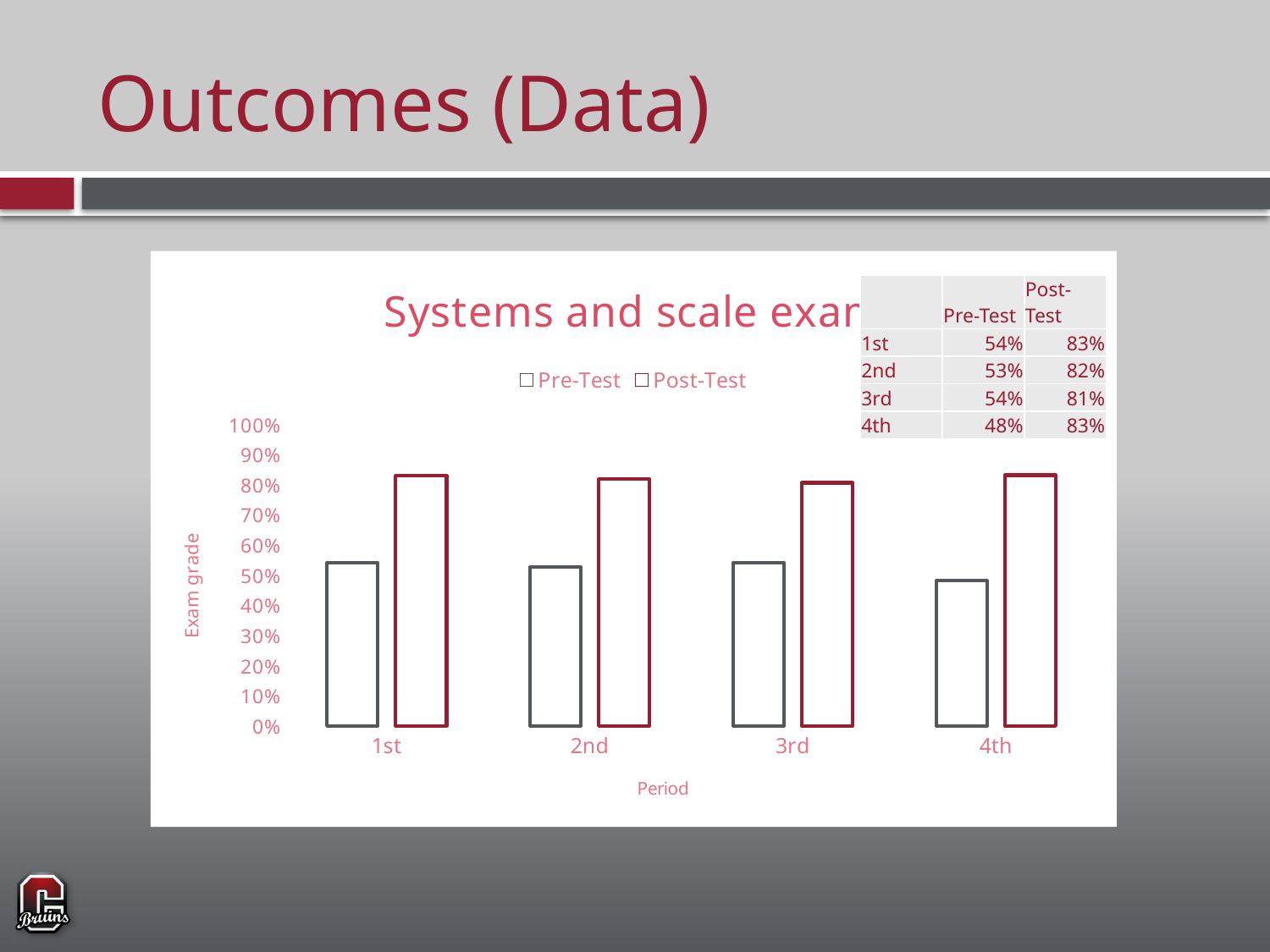
What kind of chart is shown on the slide? bar chart Is the Pre-Test value for the 4th period greater or less than 50%? less How many periods are shown along the x axis of the chart? 4 What is the Post-Test value for the 3rd period? 81% How many series does the chart's legend list? 2 What is the title of the chart's x axis? Period For the 3rd period, which is larger, the Pre-Test or the Post-Test value? Post-Test What is the Pre-Test value for the 4th period? 48% What is the Post-Test value for the 2nd period? 82% Which period has the lowest Pre-Test value? 4th What is the difference between the Post-Test and Pre-Test values for the 1st period? 29% What is the Pre-Test value for the 1st period? 54%